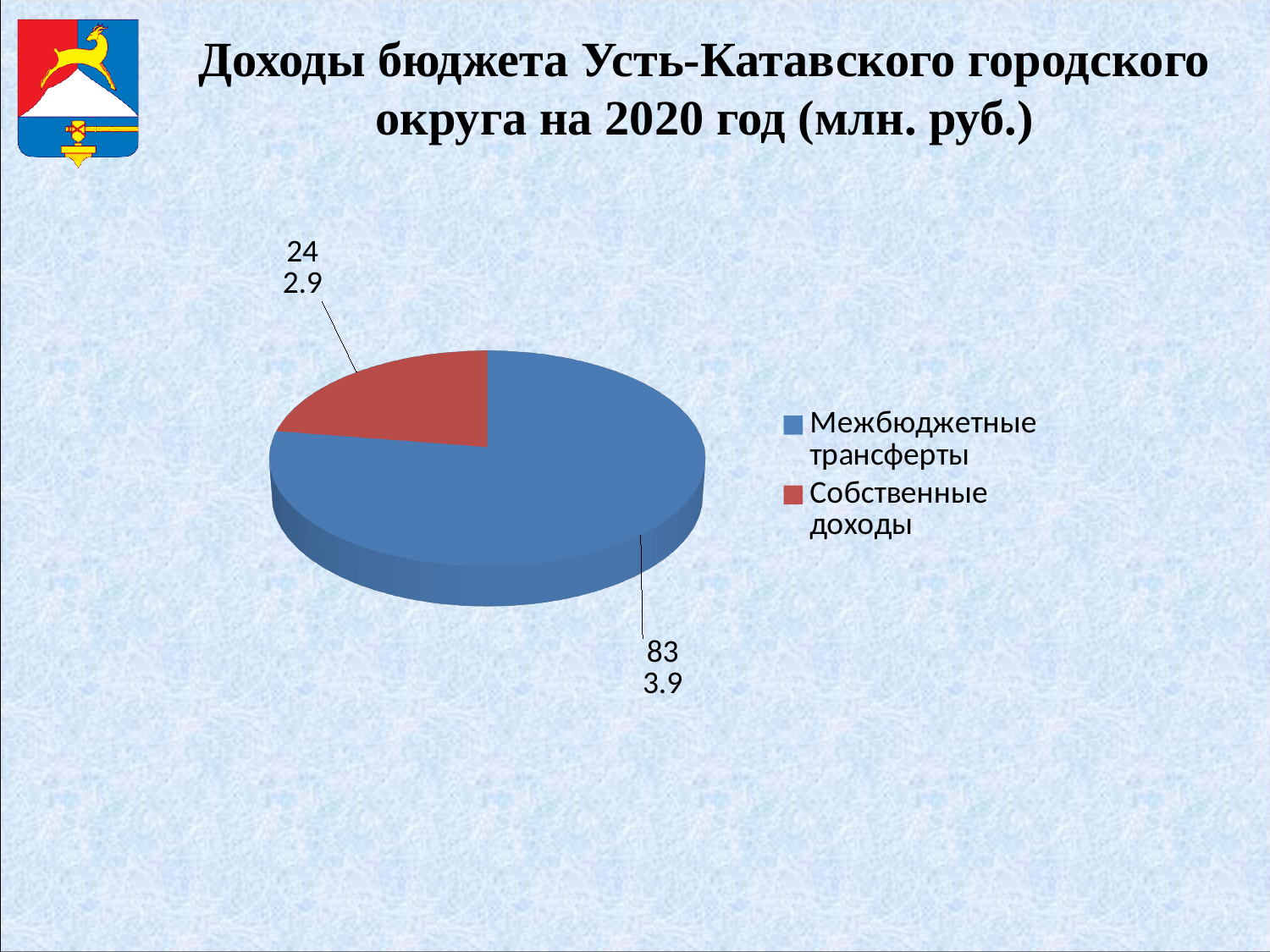
Which is larger: Межбюджетные трансферты or Собственные доходы? Межбюджетные трансферты What is the title of the chart? Доходы бюджета Усть-Катавского городского округа на 2020 год (млн. руб.) What colour is the slice for Собственные доходы? red Which category has the largest share of the pie? Межбюджетные трансферты Which category has the smallest share of the pie? Собственные доходы What kind of chart is shown on the slide? pie chart How many entries does the legend list? 2 What is the value shown for Собственные доходы? 242.9 Does Межбюджетные трансферты make up more or less than half of the pie? more What is the value shown for Межбюджетные трансферты? 833.9 How many slices does the pie chart have? 2